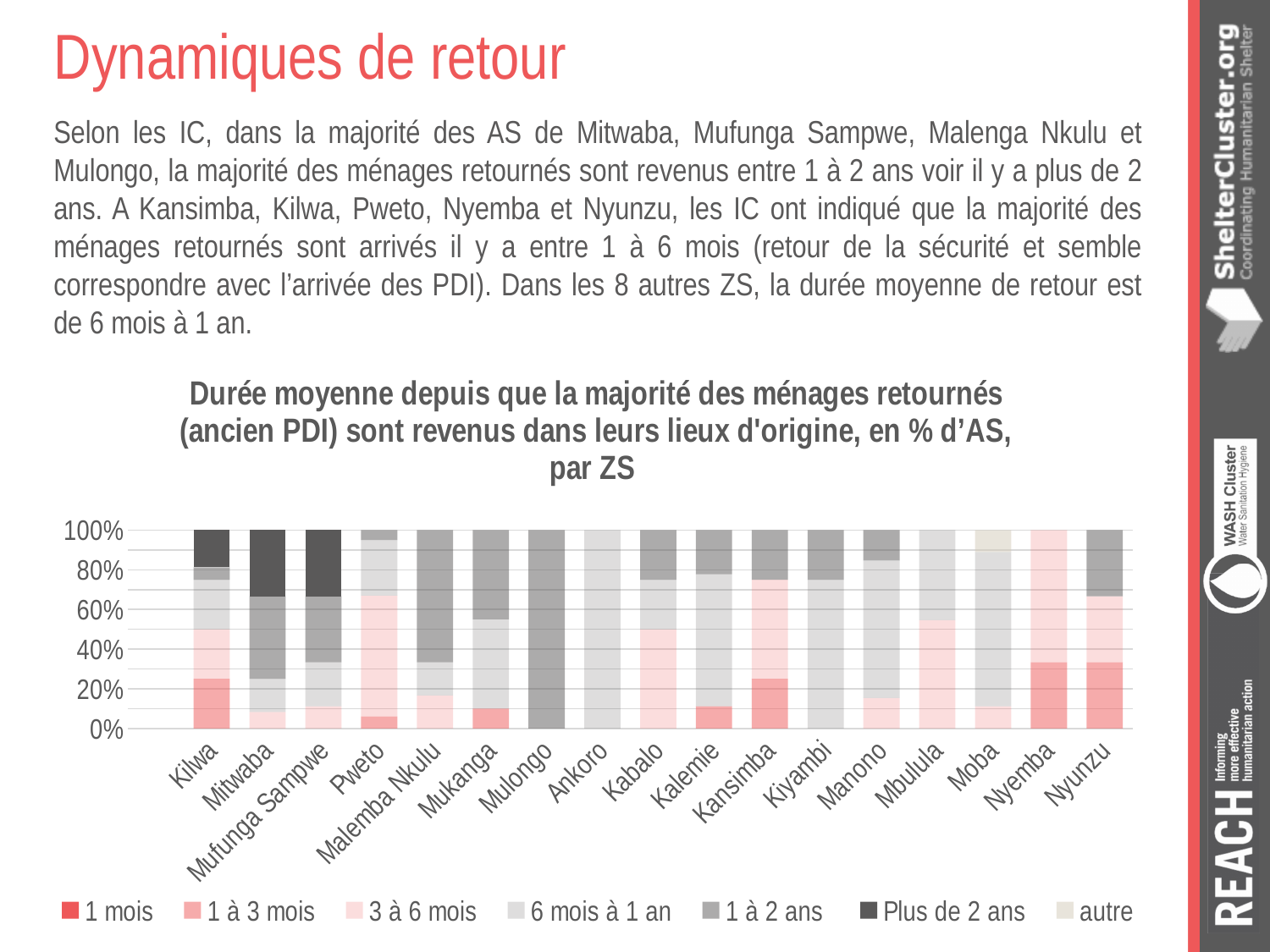
Is the share of '3 à 6 mois' for Nyemba greater or less than 50%? greater What kind of chart is shown on the slide? stacked bar chart What is the last category shown on the x axis of the chart? Nyunzu Which series is listed first in the chart legend? 1 mois Which has a larger share of 'Plus de 2 ans': Kilwa or Mitwaba? Mitwaba How many series does the chart legend list? 7 Is the share of '6 mois à 1 an' for Ankoro greater or less than 80%? greater How many ZS (categories) are shown along the x axis of the chart? 17 Is the share of '1 à 2 ans' for Mulongo greater or less than 80%? greater